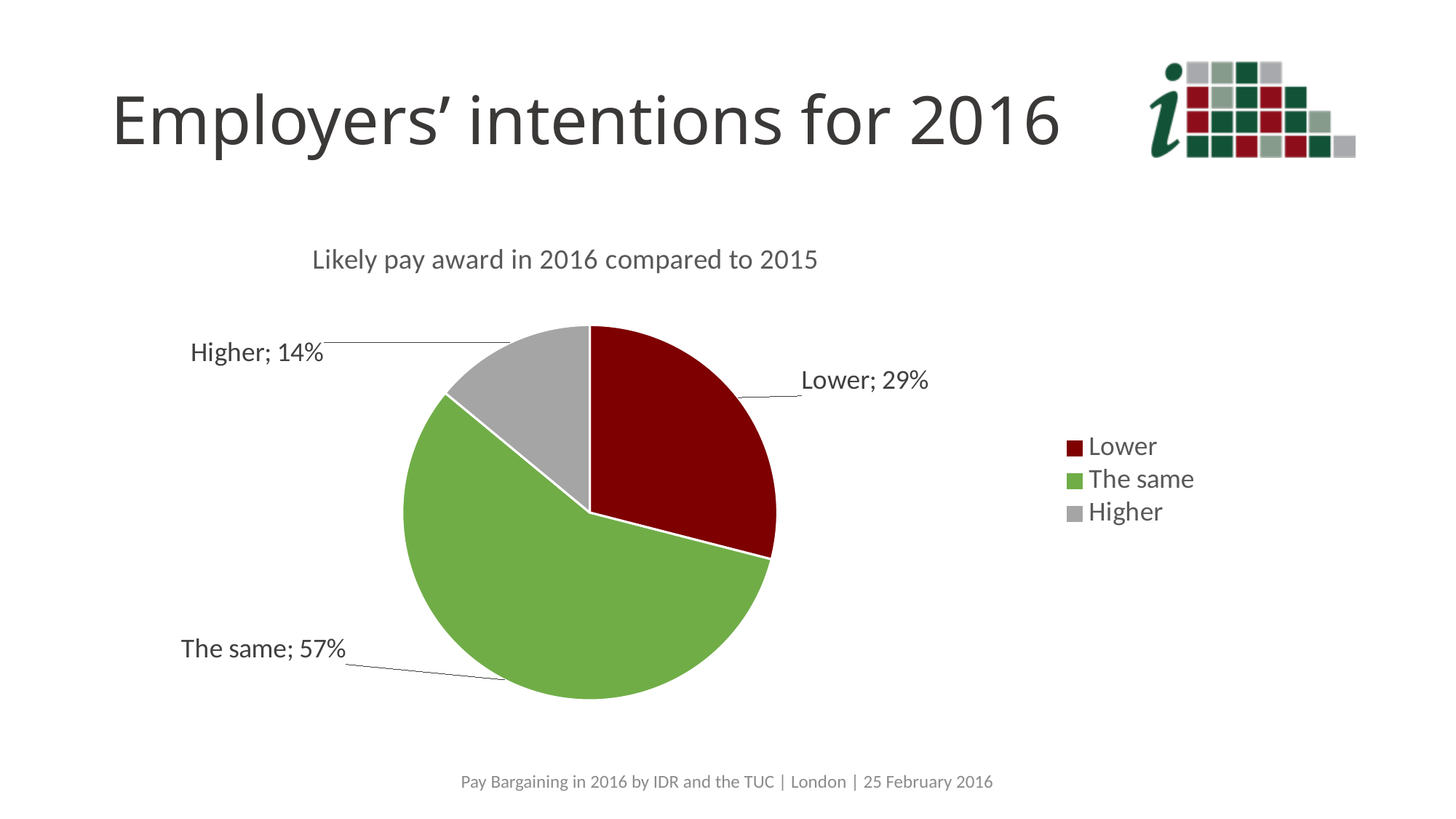
What percentage of employers expect the pay award in 2016 to be the same as in 2015? 57% Which is larger, the share for 'Lower' or the share for 'Higher'? Lower What percentage of employers expect the pay award in 2016 to be lower than in 2015? 29% What percentage of employers expect the pay award in 2016 to be higher than in 2015? 14% What is the title of the chart? Likely pay award in 2016 compared to 2015 What kind of chart is shown on the slide? Pie chart What is the difference in percentage points between 'Lower' and 'Higher'? 15 Which category has the largest share of the pie? The same What is the difference in percentage points between 'The same' and 'Lower'? 28 How many entries does the legend list? 3 Which category has the smallest share of the pie? Higher How many slices does the pie chart have? 3